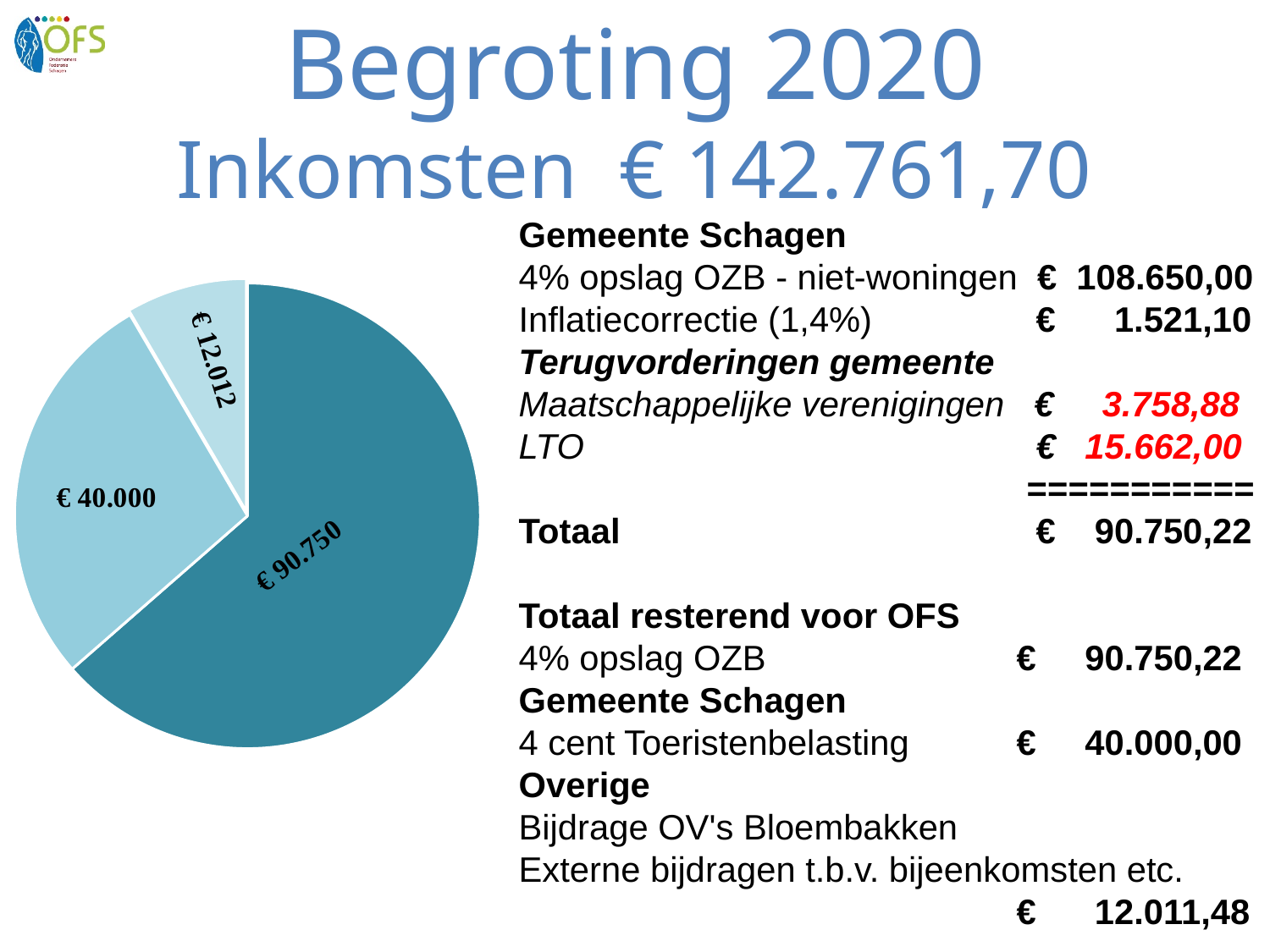
What kind of chart is shown on the slide? Pie chart Does the pie chart have a legend? No Which slice is larger: the one labelled € 40.000 or the one labelled € 12.012? € 40.000 What is the difference between the € 40.000 slice and the € 12.012 slice? € 27.988 What value is printed on the small slice at the top of the pie chart? € 12.012 What is the difference between the € 90.750 slice and the € 40.000 slice? € 50.750 What is the value printed on the largest slice of the pie chart? € 90.750 How many slices does the pie chart have? 3 What value is printed on the light blue slice on the left side of the pie chart? € 40.000 What value is printed on the dark teal slice of the pie chart? € 90.750 What is the value printed on the smallest slice of the pie chart? € 12.012 What is the sum of the three values printed on the pie chart slices? € 142.762